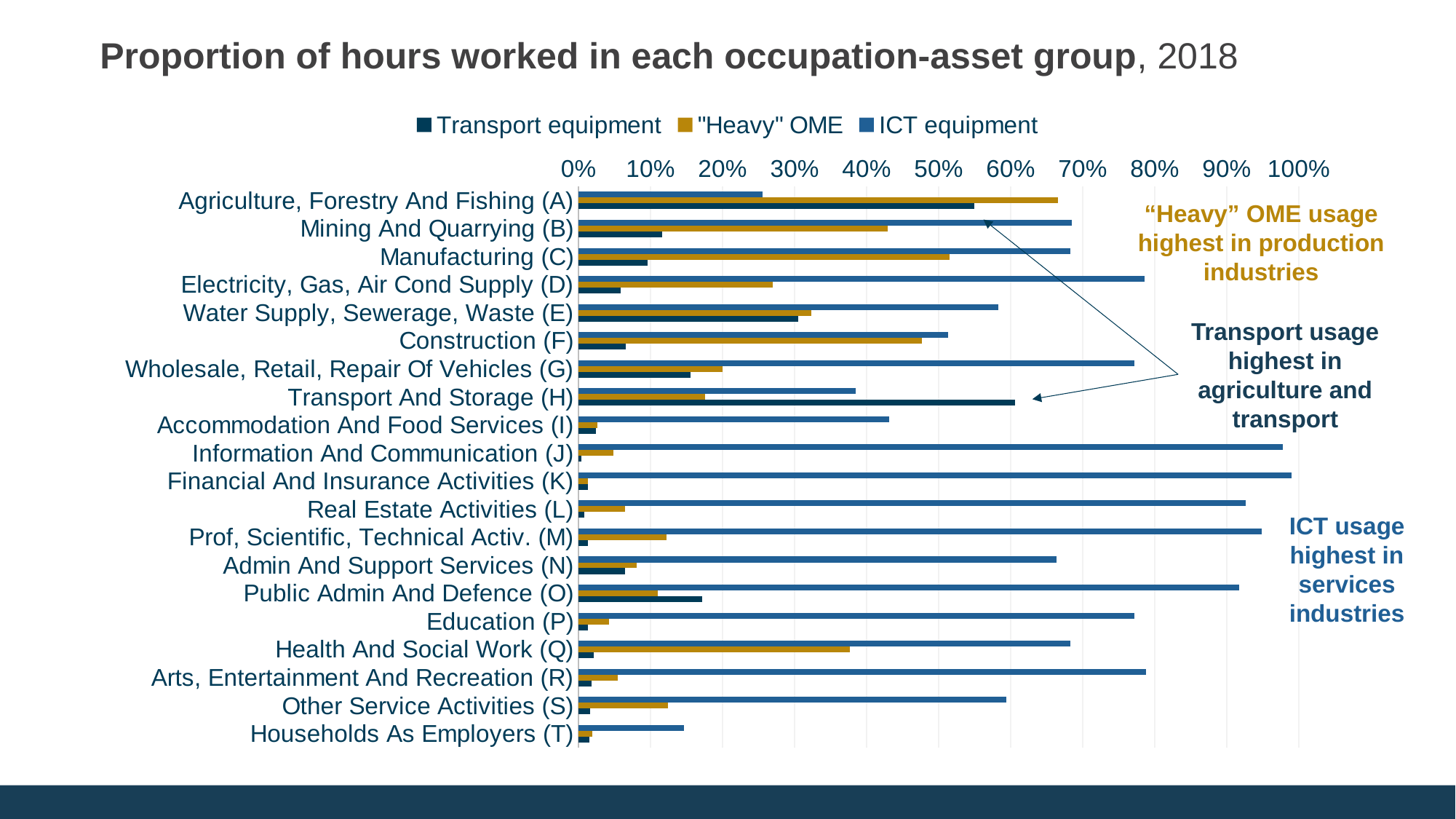
Is the ICT equipment value for Information And Communication (J) greater or less than 90%? greater What year does the chart title refer to? 2018 Which industry has the highest Transport equipment value? Transport And Storage (H) Which is larger for Construction (F): the ICT equipment value or the Transport equipment value? ICT equipment Is the Transport equipment value for Agriculture, Forestry And Fishing (A) greater or less than 50%? greater Which industry has the highest "Heavy" OME value? Agriculture, Forestry And Fishing (A) Is the "Heavy" OME value for Mining And Quarrying (B) greater or less than 50%? less How many industry categories are plotted on the chart? 20 Which is larger for Health And Social Work (Q): the "Heavy" OME value or the Transport equipment value? "Heavy" OME Which industry has the lowest ICT equipment value? Households As Employers (T) How many series does the legend list? 3 What kind of chart is shown on the slide? bar chart